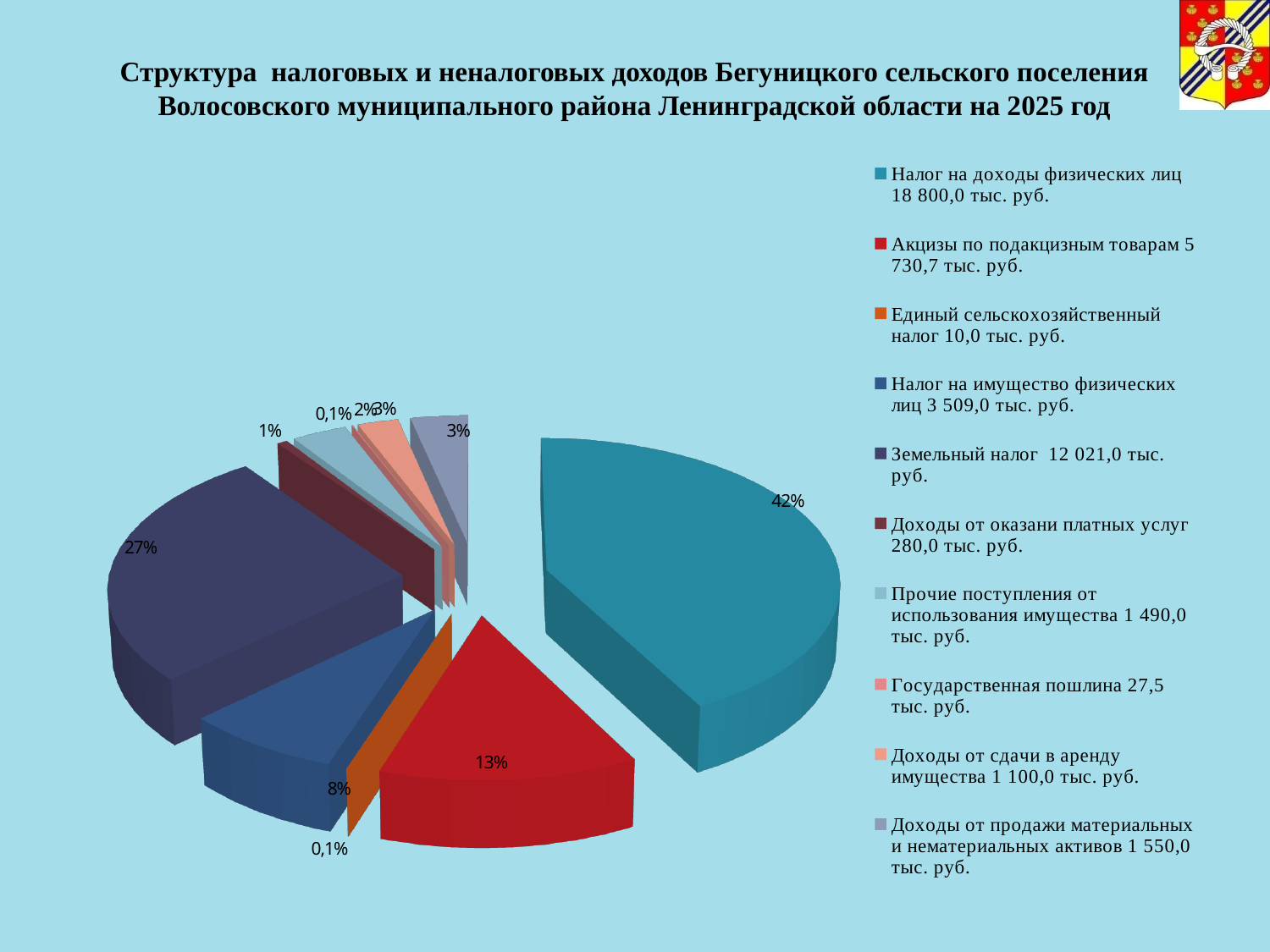
What share of the pie does "Налог на имущество физических лиц" take? 8% Which is larger: the slice for "Земельный налог" or the slice for "Акцизы по подакцизным товарам"? Земельный налог By how much does the amount for "Налог на доходы физических лиц" exceed the amount for "Земельный налог" according to the legend? 6 779,0 тыс. руб. How many categories does the legend of the pie chart list? 10 According to the legend, what is the amount for "Налог на имущество физических лиц"? 3 509,0 тыс. руб. According to the legend, what is the amount for "Государственная пошлина"? 27,5 тыс. руб. Which category has the largest slice of the pie? Налог на доходы физических лиц What share of the pie does "Акцизы по подакцизным товарам" take? 13% What share of the pie does "Налог на доходы физических лиц" take? 42% What kind of chart is shown on the slide? Pie chart What colour is the largest slice of the pie? Teal (blue-green)